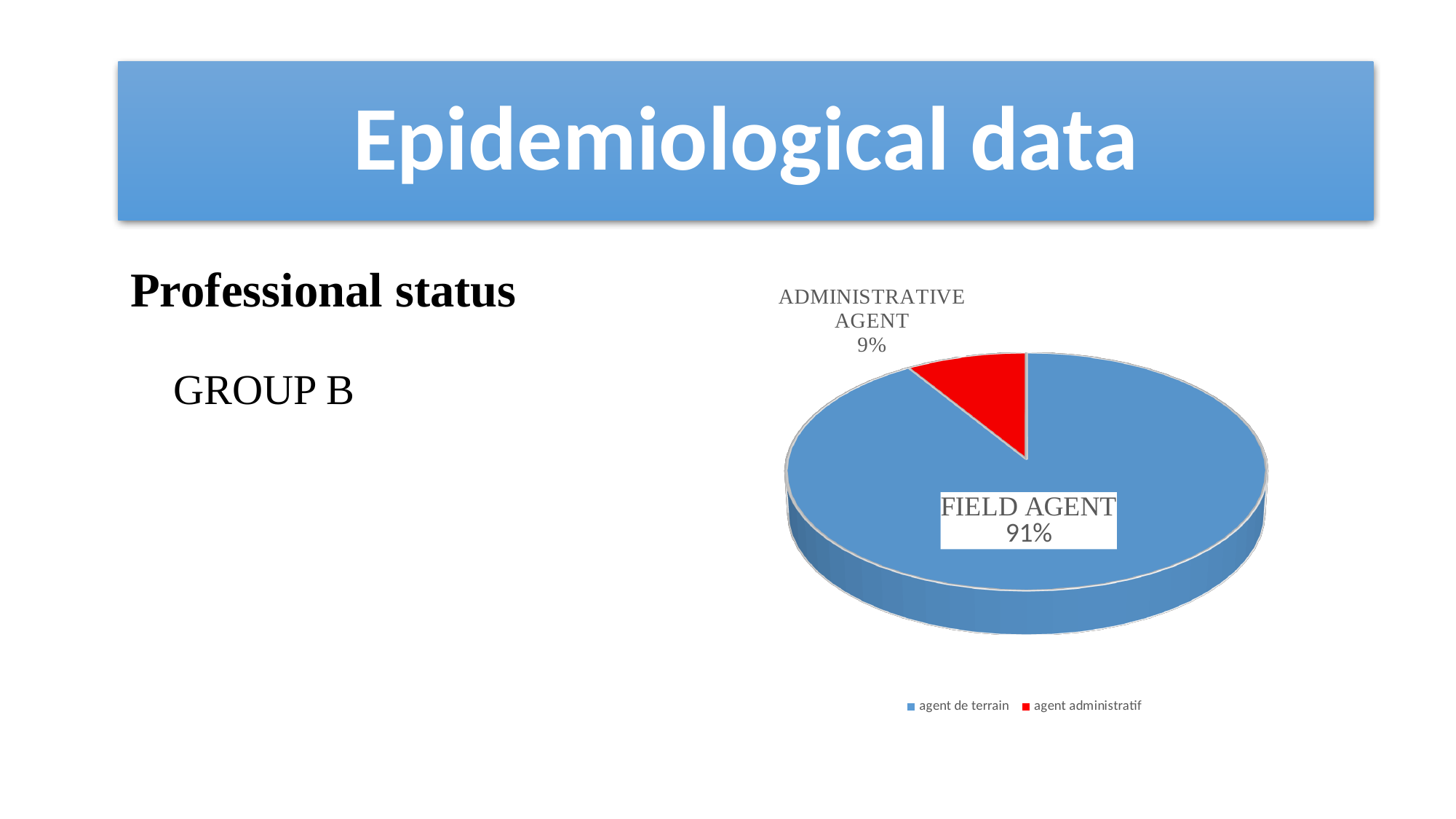
How many entries does the chart legend list? 2 How many slices does the pie chart have? 2 What is the difference in percentage points between the FIELD AGENT and ADMINISTRATIVE AGENT slices? 82 What is the first legend entry of the pie chart? agent de terrain Which category has the smallest slice in the pie chart? ADMINISTRATIVE AGENT What share of the pie chart is labelled ADMINISTRATIVE AGENT? 9% What kind of chart is shown on the slide? Pie chart Which category has the largest slice in the pie chart? FIELD AGENT What share of the pie chart is labelled FIELD AGENT? 91% Which slice is larger, FIELD AGENT or ADMINISTRATIVE AGENT? FIELD AGENT What colour is the ADMINISTRATIVE AGENT slice in the pie chart? Red